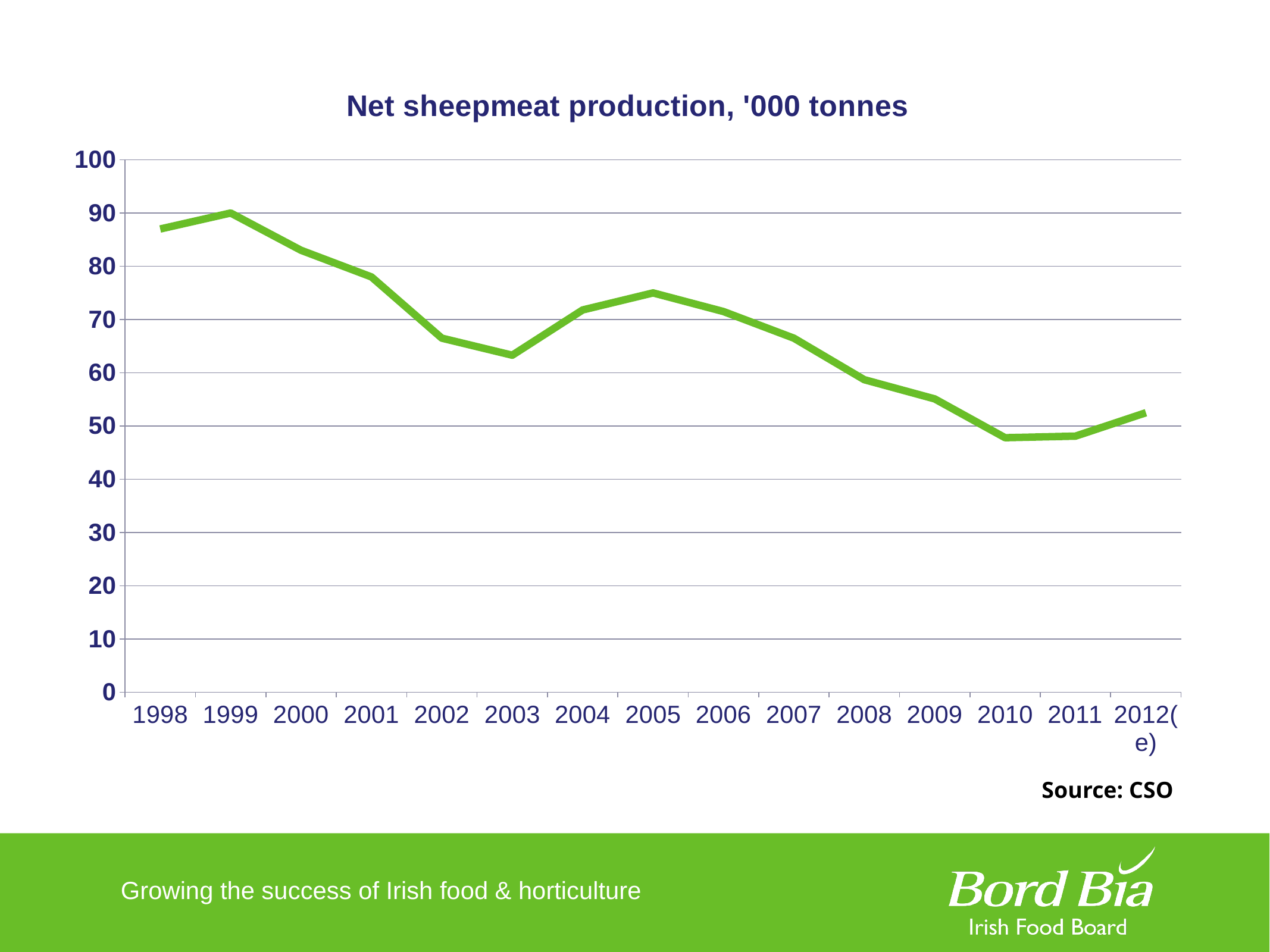
What is the title of the chart? Net sheepmeat production, '000 tonnes Overall, does net sheepmeat production rise or fall from 1998 to 2012(e)? fall Is the value for 1998 greater or less than 80? greater Which year has the highest net sheepmeat production? 1999 Which is larger, the value for 2003 or the value for 2005? 2005 Is the value for 2003 greater or less than 70? less What kind of chart is shown on the slide? line chart How many years are plotted on the x axis? 15 Is the value for 2005 greater or less than 70? greater Which is larger, the value for 2001 or the value for 2002? 2001